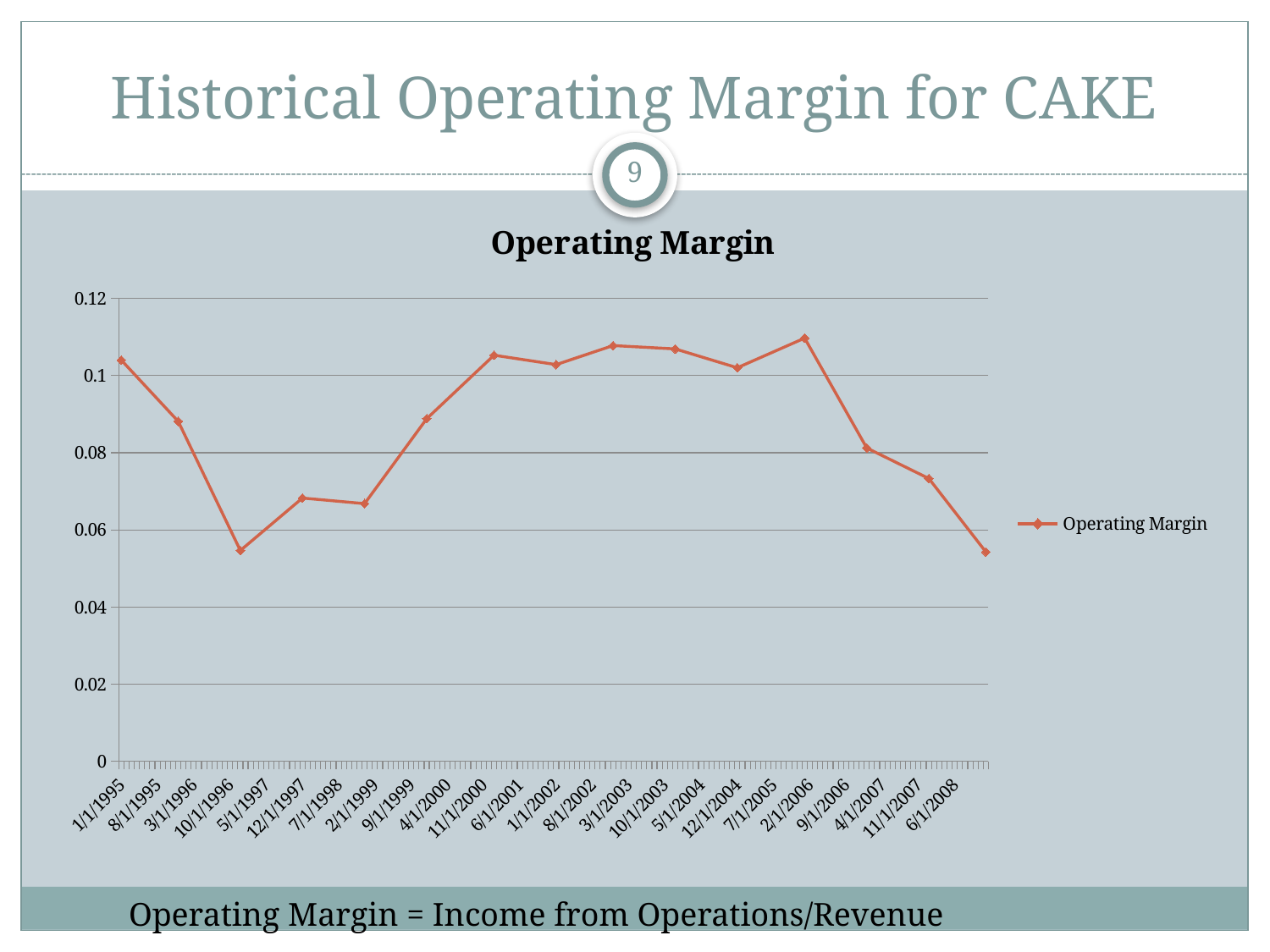
What kind of chart is shown on the slide? line chart Is the highest point on the line greater or less than 0.12? less Which is higher, the first point or the last point on the line? the first point Is the value for the last point on the line greater or less than 0.06? less From the first point in 1995 to the low point in 1996, does the line rise or fall? fall What is the title of the chart? Operating Margin Is the value for the first point (1/1/1995) greater or less than 0.1? greater Over the final three points of the line, do the values rise or fall? fall How many series does the legend list? 1 What is the name of the series shown in the legend? Operating Margin How many data points are plotted on the line? 15